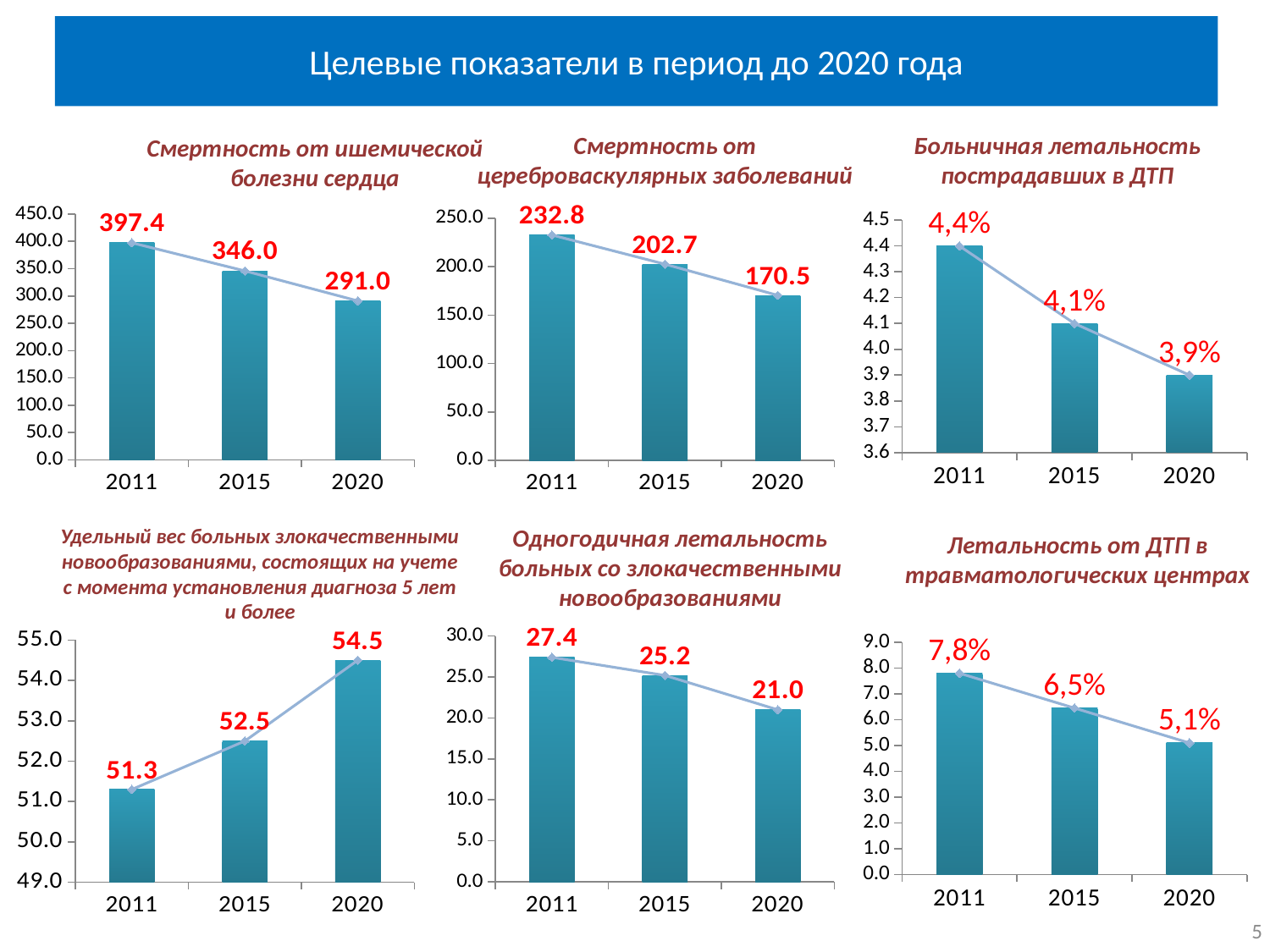
In the chart titled "Летальность от ДТП в травматологических центрах", what is the value for 2011? 7,8% In the chart titled "Удельный вес больных злокачественными новообразованиями, состоящих на учете с момента установления диагноза 5 лет и более", which year has the highest value? 2020 In the chart titled "Смертность от ишемической болезни сердца", what is the value for 2011? 397.4 In the chart titled "Больничная летальность пострадавших в ДТП", what is the value for 2015? 4,1% In the chart titled "Удельный вес больных злокачественными новообразованиями, состоящих на учете с момента установления диагноза 5 лет и более", do the values rise or fall from 2011 to 2020? rise What kind of chart is the chart titled "Больничная летальность пострадавших в ДТП"? bar chart with a line In the chart titled "Смертность от ишемической болезни сердца", what is the difference between the 2011 value and the 2020 value? 106.4 In the chart titled "Одногодичная летальность больных со злокачественными новообразованиями", which is larger: the value for 2011 or the value for 2015? 2011 How many years are shown on the x axis of the chart titled "Летальность от ДТП в травматологических центрах"? 3 In the chart titled "Смертность от цереброваскулярных заболеваний", what is the value for 2020? 170.5 In the chart titled "Смертность от цереброваскулярных заболеваний", what is the difference between the 2011 value and the 2015 value? 30.1 In the chart titled "Одногодичная летальность больных со злокачественными новообразованиями", which year has the lowest value? 2020